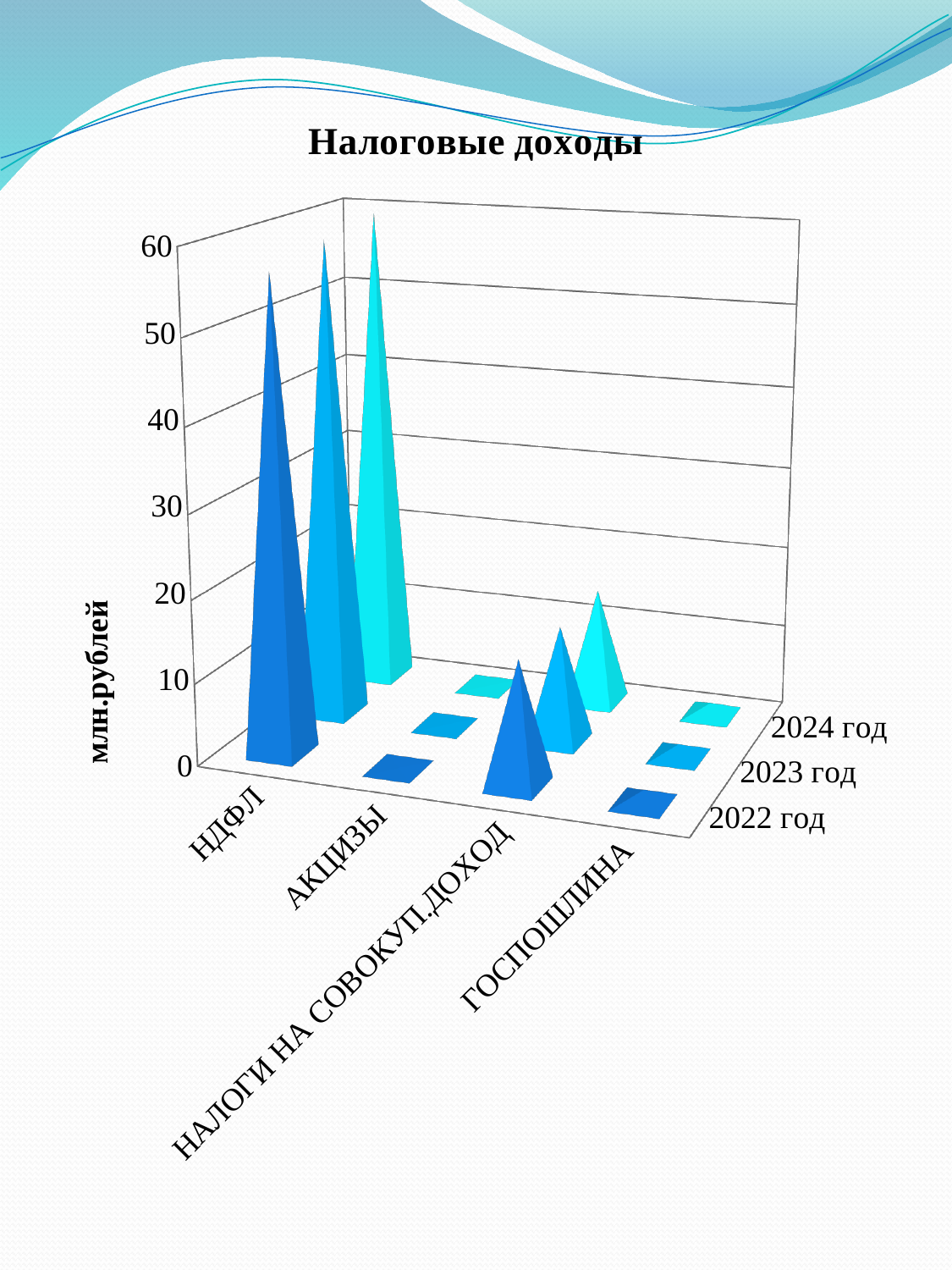
How many categories are shown on the x axis of the chart? 4 Is the value for АКЦИЗЫ in 2023 год greater or less than 10? less What is the title of the chart? Налоговые доходы Which is larger in 2024 год: НАЛОГИ НА СОВОКУП.ДОХОД or АКЦИЗЫ? НАЛОГИ НА СОВОКУП.ДОХОД Is the value for НДФЛ in 2022 год greater or less than 30? greater Which category has the highest values in the chart? НДФЛ Which category has the second highest values in the chart? НАЛОГИ НА СОВОКУП.ДОХОД What kind of chart is shown on the slide? bar chart How many series (years) does the chart show? 3 Which is larger in 2022 год: НДФЛ or ГОСПОШЛИНА? НДФЛ Is the value for НАЛОГИ НА СОВОКУП.ДОХОД in 2024 год greater or less than 30? less What unit is shown on the vertical axis label of the chart? млн.рублей